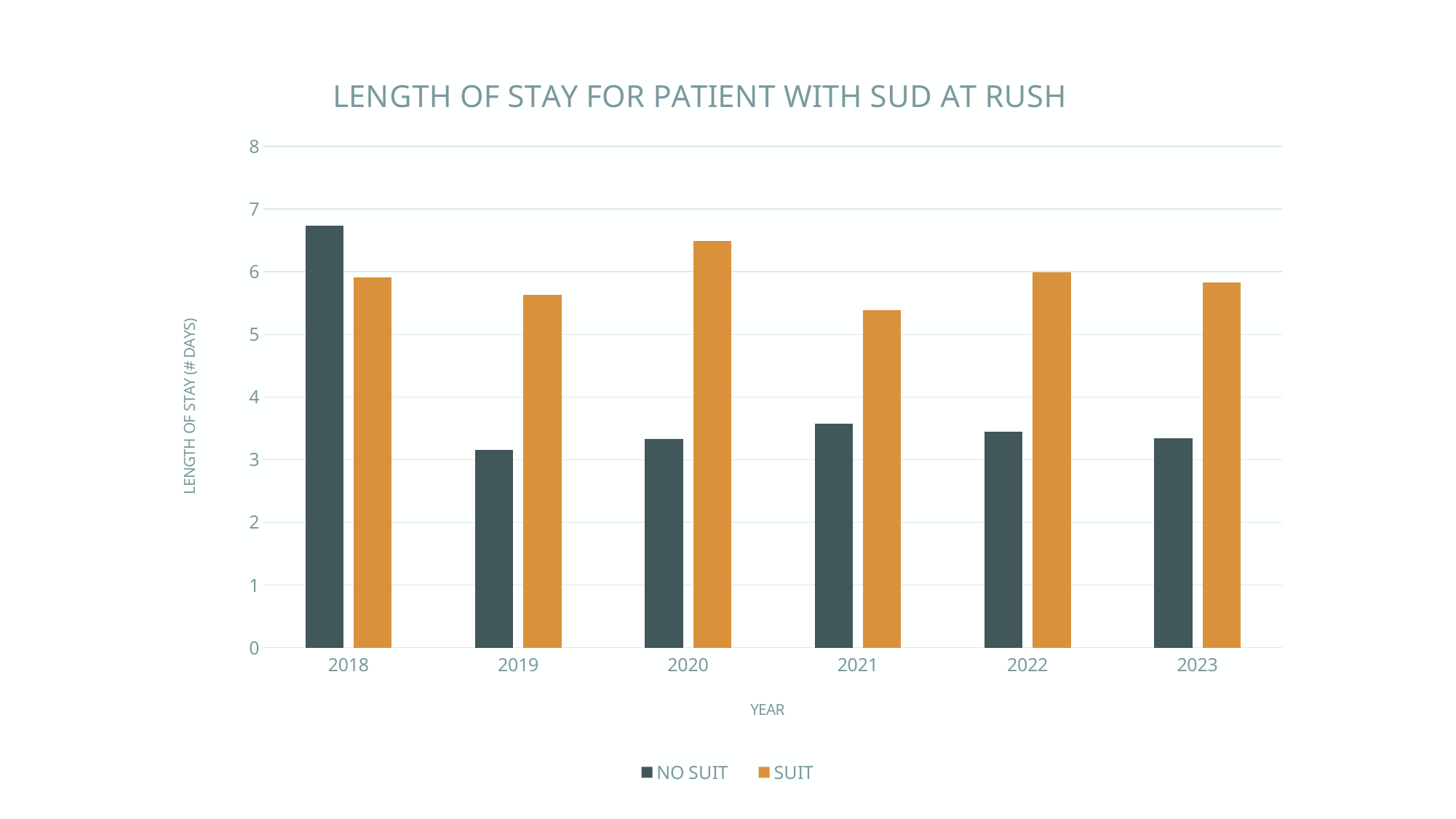
In 2019, which series has the larger value, NO SUIT or SUIT? SUIT Is the NO SUIT value for 2018 greater or less than 6? greater Is the NO SUIT value for 2019 greater or less than 4? less How many years are shown on the x axis? 6 Is the SUIT value for 2021 greater or less than 6? less In which year is the SUIT length of stay highest? 2020 What is the label of the vertical axis? LENGTH OF STAY (# DAYS) In 2018, which series has the larger value, NO SUIT or SUIT? NO SUIT In which year is the SUIT length of stay lowest? 2021 In which year is the NO SUIT length of stay highest? 2018 How many series does the legend list? 2 What kind of chart is shown on the slide? Bar chart